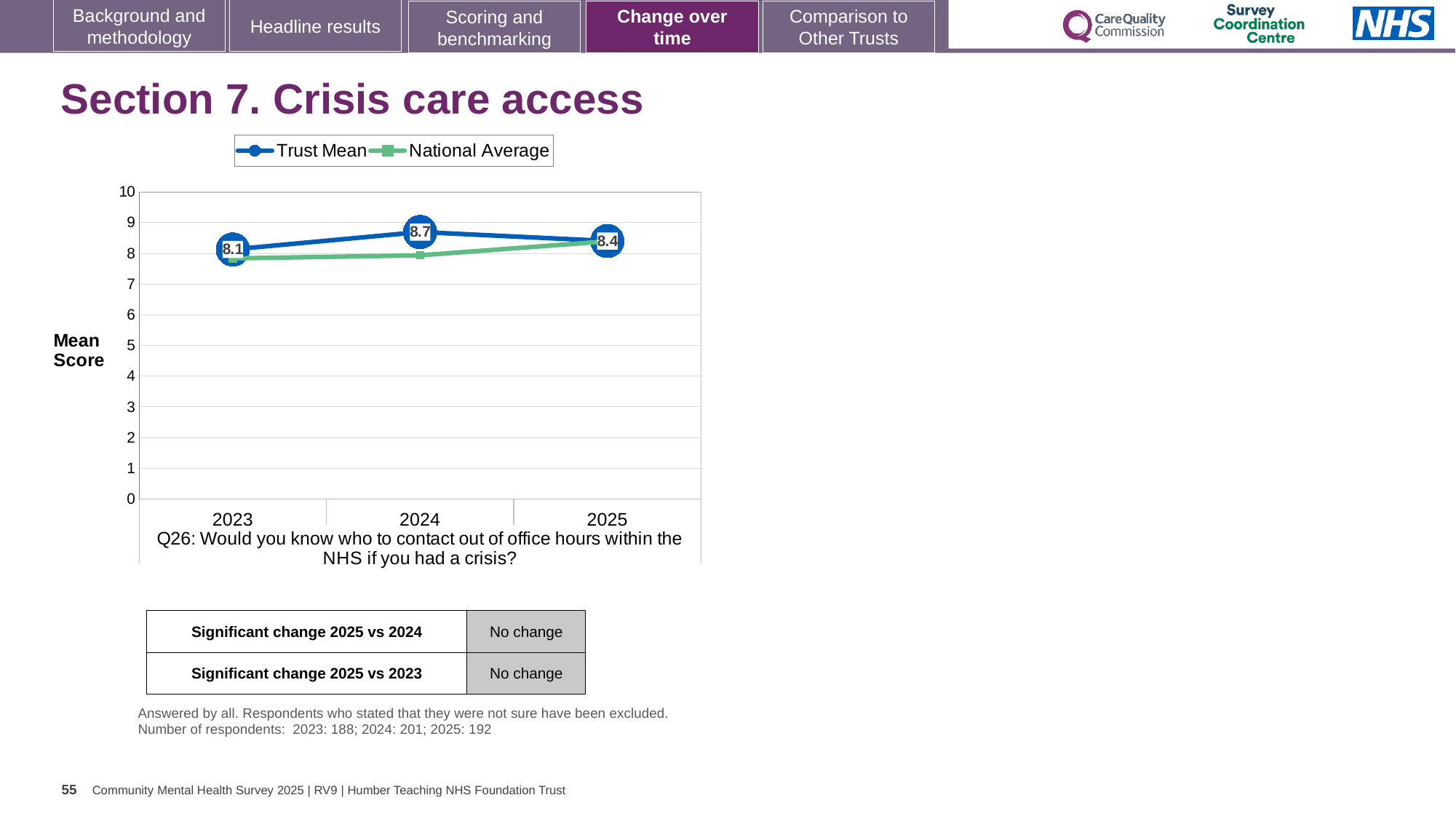
How many years are plotted on the x axis? 3 Does the Trust Mean rise or fall from 2023 to 2024? Rise Is the National Average value for 2023 greater or less than 7? greater Which is larger, the Trust Mean in 2024 or in 2025? 2024 What is the Trust Mean score for 2025? 8.4 What is the Trust Mean score for 2024? 8.7 What is the difference between the Trust Mean in 2024 and in 2023? 0.6 In which year is the Trust Mean highest? 2024 How many series does the legend list? 2 What kind of chart is shown on the slide? Line chart What is the Trust Mean score for 2023? 8.1 In which year is the Trust Mean lowest? 2023